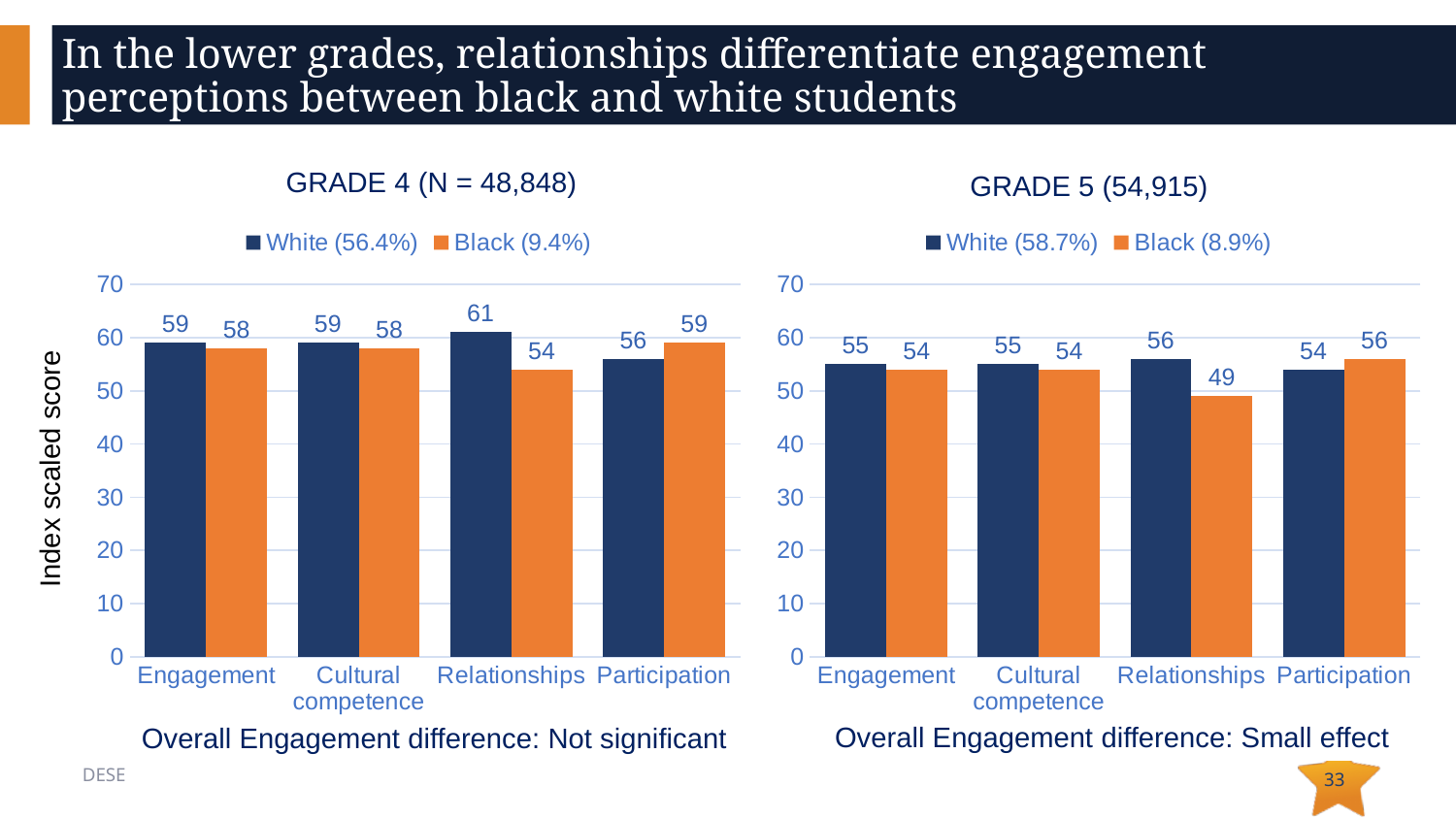
In the GRADE 4 chart, what is the value for Black students on Relationships? 54 In the GRADE 4 chart, which is larger for Participation: the White value or the Black value? Black In the GRADE 5 chart, is the Black value for Relationships greater or less than 50? less In the GRADE 5 chart, which category has the lowest value for Black students? Relationships In the GRADE 4 chart, what is the difference between the White and Black values for Relationships? 7 In the GRADE 5 chart, what is the value for White students on Participation? 54 How many series does the legend of the GRADE 4 chart list? 2 In the GRADE 4 chart, which category has the highest value for White students? Relationships In the GRADE 5 chart, what is the difference between the White and Black values for Relationships? 7 How many categories are shown on the x axis of the GRADE 5 chart? 4 What is the y-axis label shared by the two charts? Index scaled score What kind of chart is the GRADE 5 chart? Bar chart